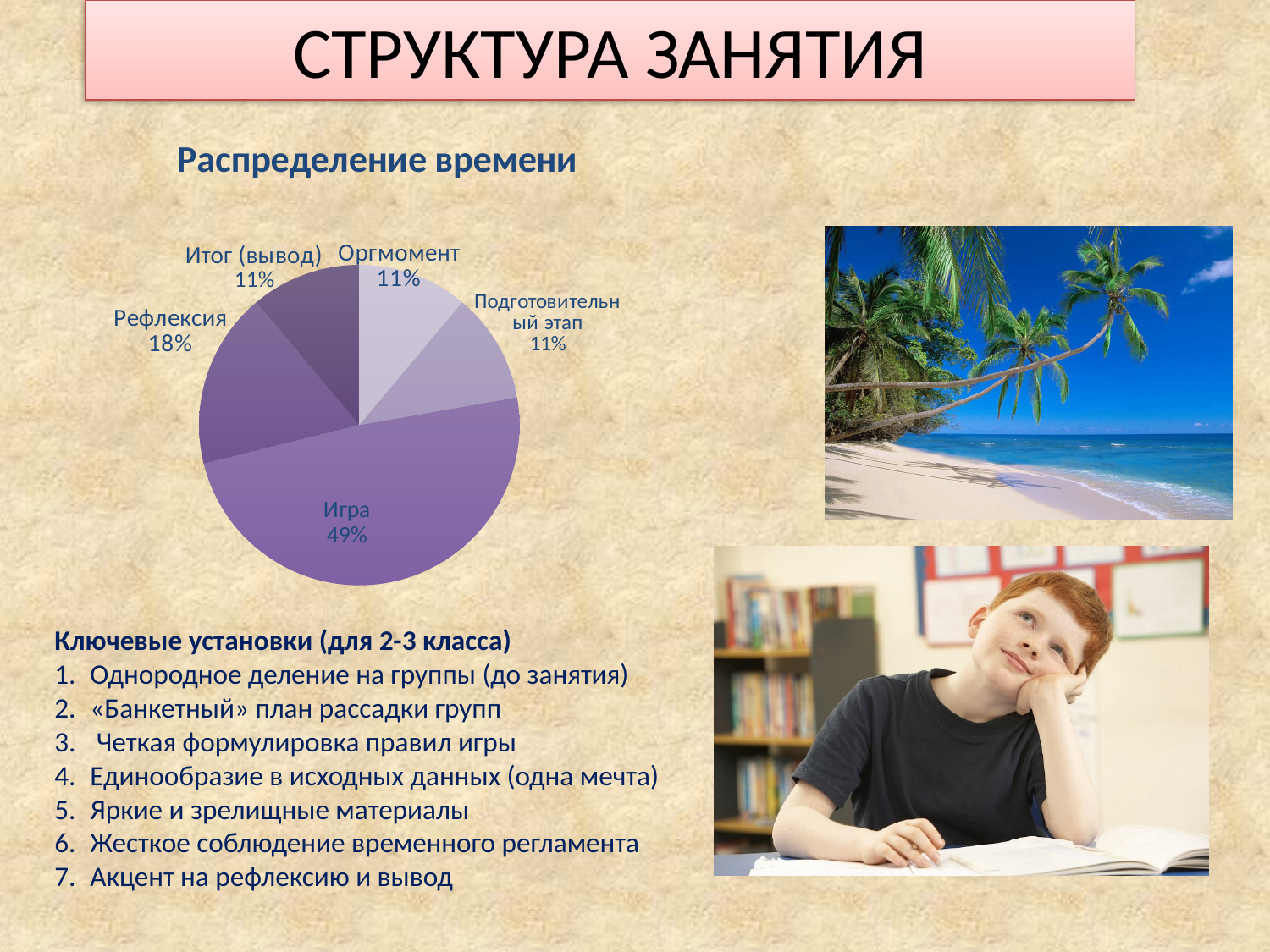
What percentage is shown for Рефлексия? 18% What is the difference in percentage points between Игра and Рефлексия? 31 Which is larger, Рефлексия or Подготовительный этап? Рефлексия What type of chart is shown on the slide? pie chart How many slices does the pie chart have? 5 Is the share for Игра greater or less than 50%? less Which slice of the pie chart is the largest? Игра What share of the pie does Игра take? 49% What is the combined share of Оргмомент and Подготовительный этап? 22% What is the title of the chart? Распределение времени What percentage is shown for Оргмомент? 11% What percentage is shown for Итог (вывод)? 11%